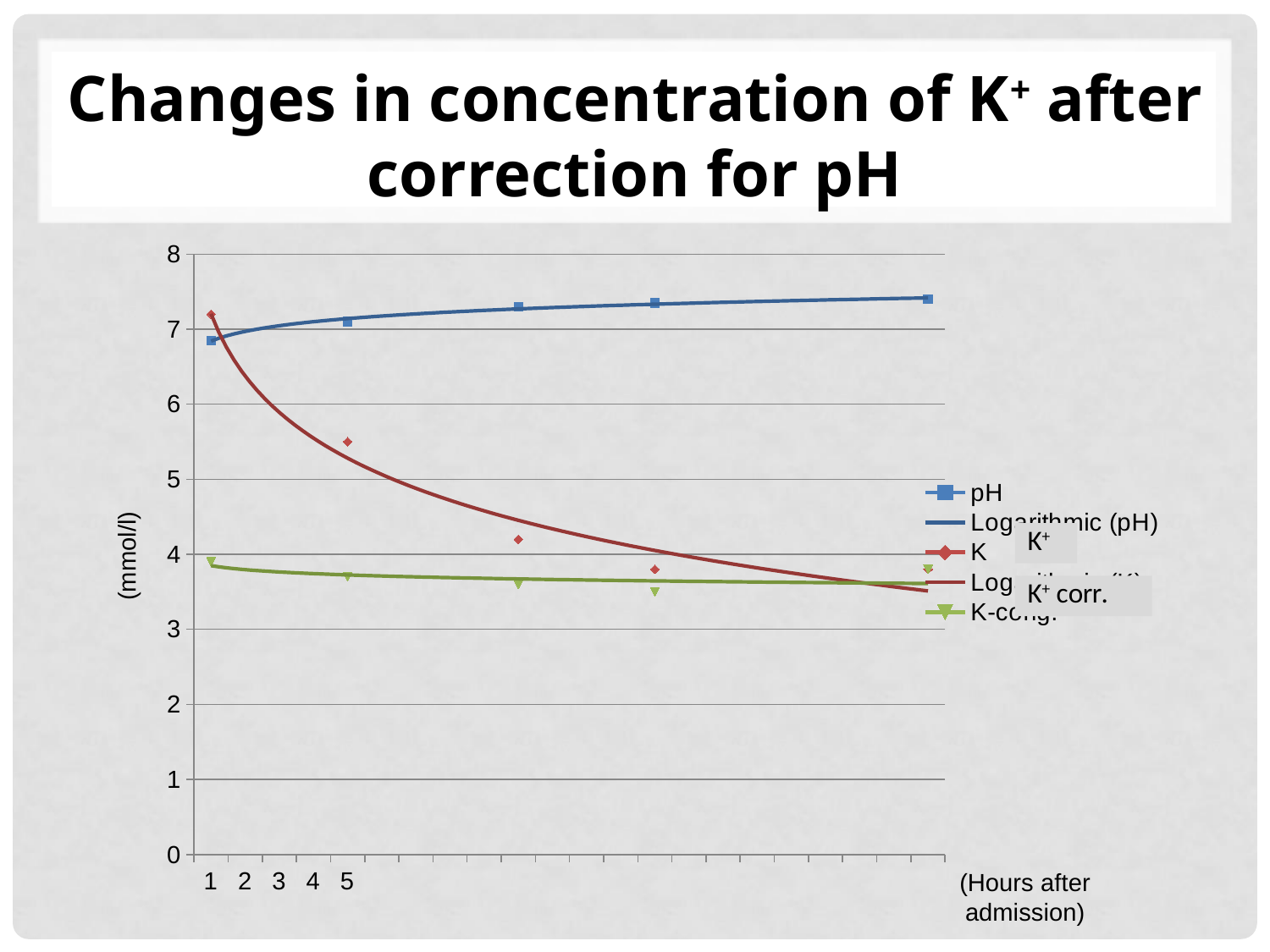
Which series has the lowest value at the first plotted point? K-corr Is the value of the pH series at its last point greater or less than 7? greater How many data points are plotted for the K series? 5 At the last plotted point, which series has the larger value, pH or K? pH Which series has the highest value at the last plotted point? pH Is the value of the K-corr series at its last point greater or less than 4? less What is the label on the vertical axis of the chart? (mmol/l) Is the value of the K series at its second point greater or less than 5? greater What is the title of the chart? Changes in concentration of K+ after correction for pH Do the values of the pH series rise or fall along the x axis? rise Do the values of the K series rise or fall along the x axis? fall What kind of chart is shown on the slide? line chart